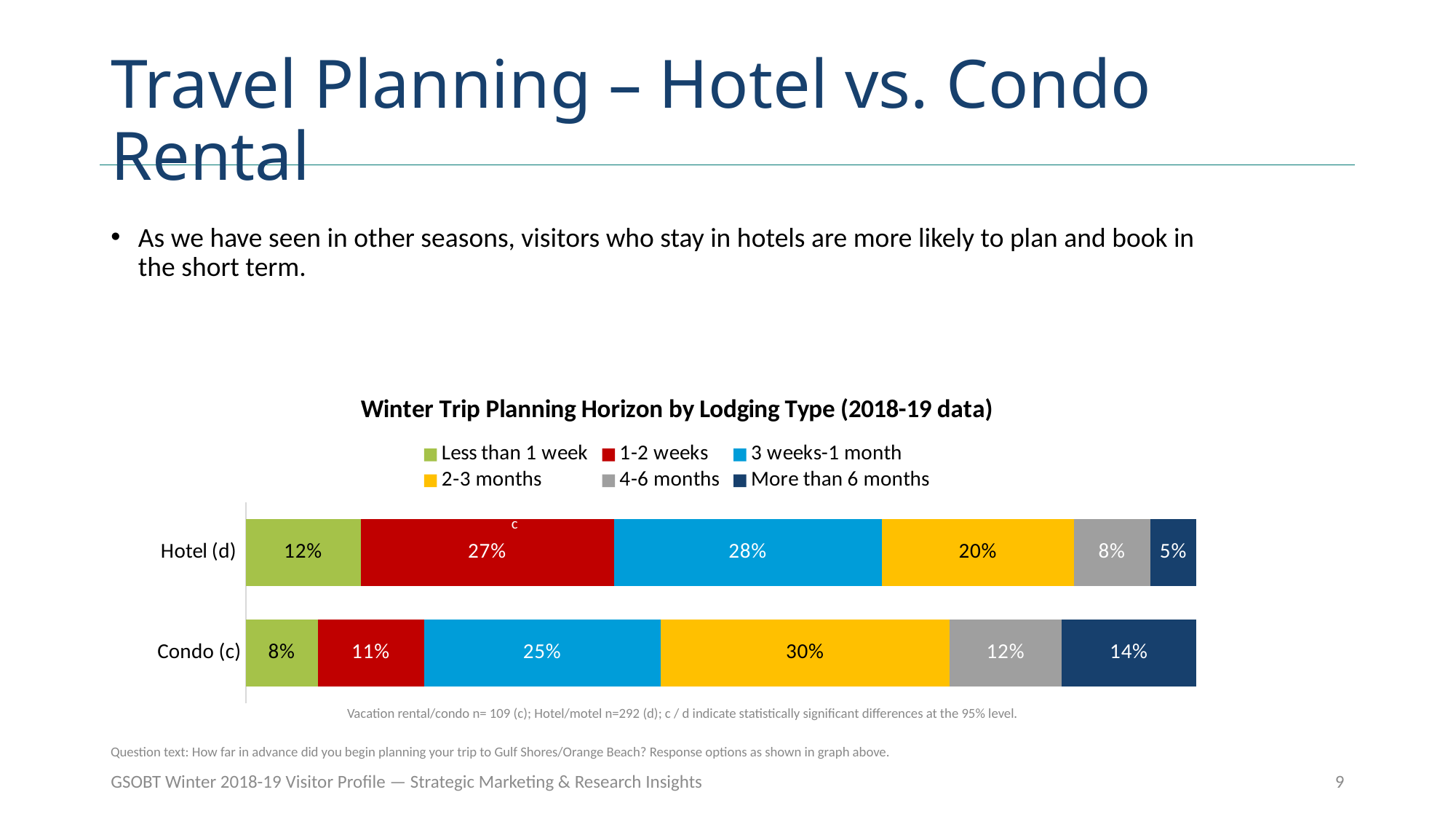
What is the title of the chart? Winter Trip Planning Horizon by Lodging Type (2018-19 data) What kind of chart is shown on the slide? Stacked bar chart How many series does the legend list? 6 Which planning horizon has the lowest share for Condo (c)? Less than 1 week What percentage of Hotel (d) visitors planned 1-2 weeks in advance? 27% What is the value for More than 6 months for Condo (c)? 14% Which planning horizon has the highest share for Hotel (d)? 3 weeks-1 month Which lodging type has the larger share for More than 6 months, Hotel (d) or Condo (c)? Condo (c) How many lodging types are shown on the chart? 2 What percentage of Condo (c) visitors planned 2-3 months in advance? 30% What is the difference between the 1-2 weeks values for Hotel (d) and Condo (c)? 16 percentage points What is the value for Less than 1 week for Hotel (d)? 12%